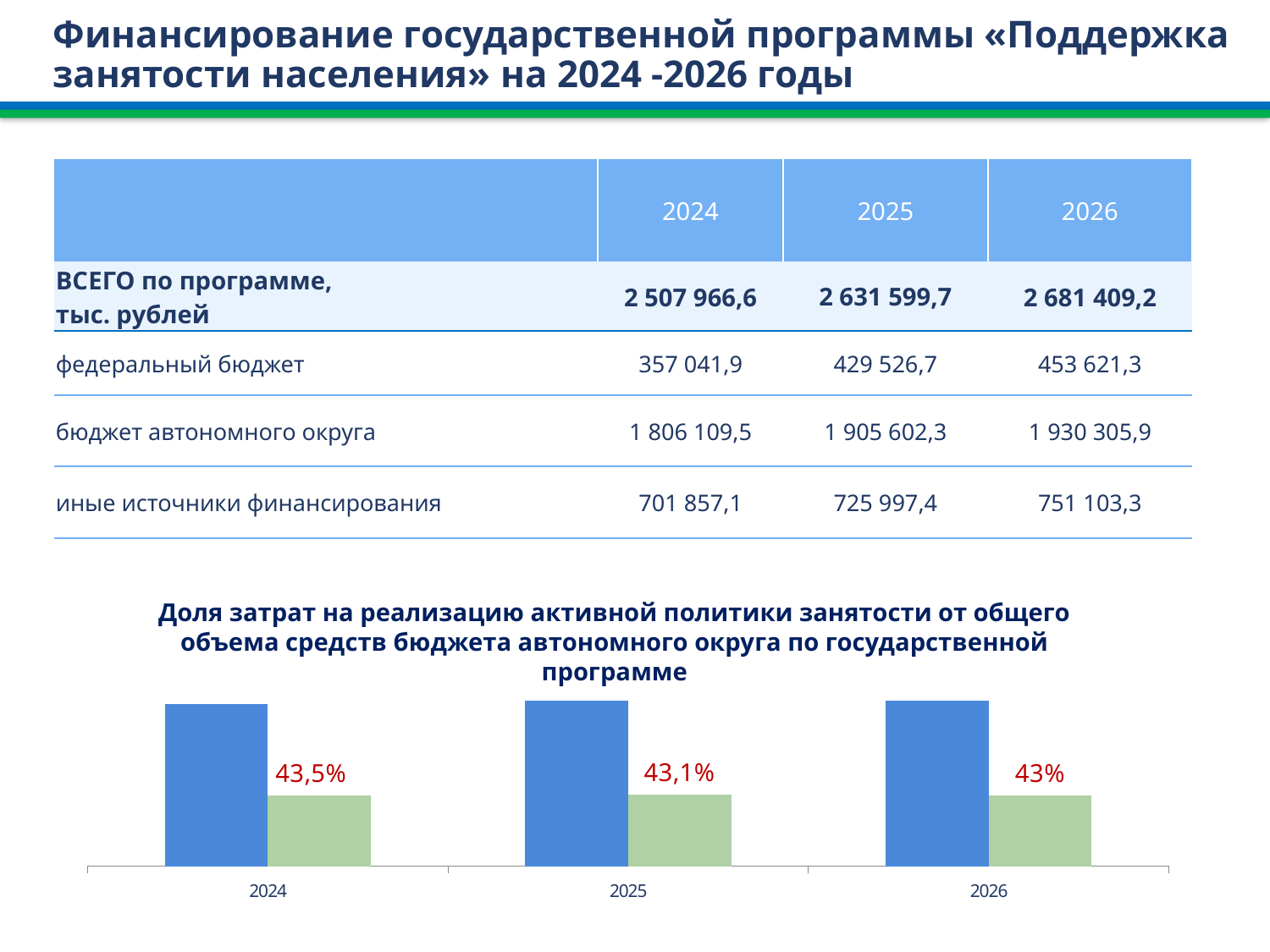
What colour are the bars that carry the percentage labels in the bar chart? green What kind of chart is shown at the bottom of the slide? bar chart In the bar chart, what is the difference between the labelled percentage for 2024 and for 2026? 0,5% In the bar chart, do the labelled percentages rise or fall from 2024 to 2026? fall In the bar chart, for 2026, is the blue bar taller or shorter than the green bar? taller In the bar chart, is the labelled percentage for 2025 larger or smaller than that for 2024? smaller How many years are shown on the x axis of the bar chart? 3 In the bar chart, what percentage is labelled for 2026? 43% In the bar chart, what percentage is labelled for 2025? 43,1% In the bar chart, which year has the highest labelled percentage? 2024 In the bar chart, which year has the lowest labelled percentage? 2026 In the bar chart, what percentage is labelled for 2024? 43,5%